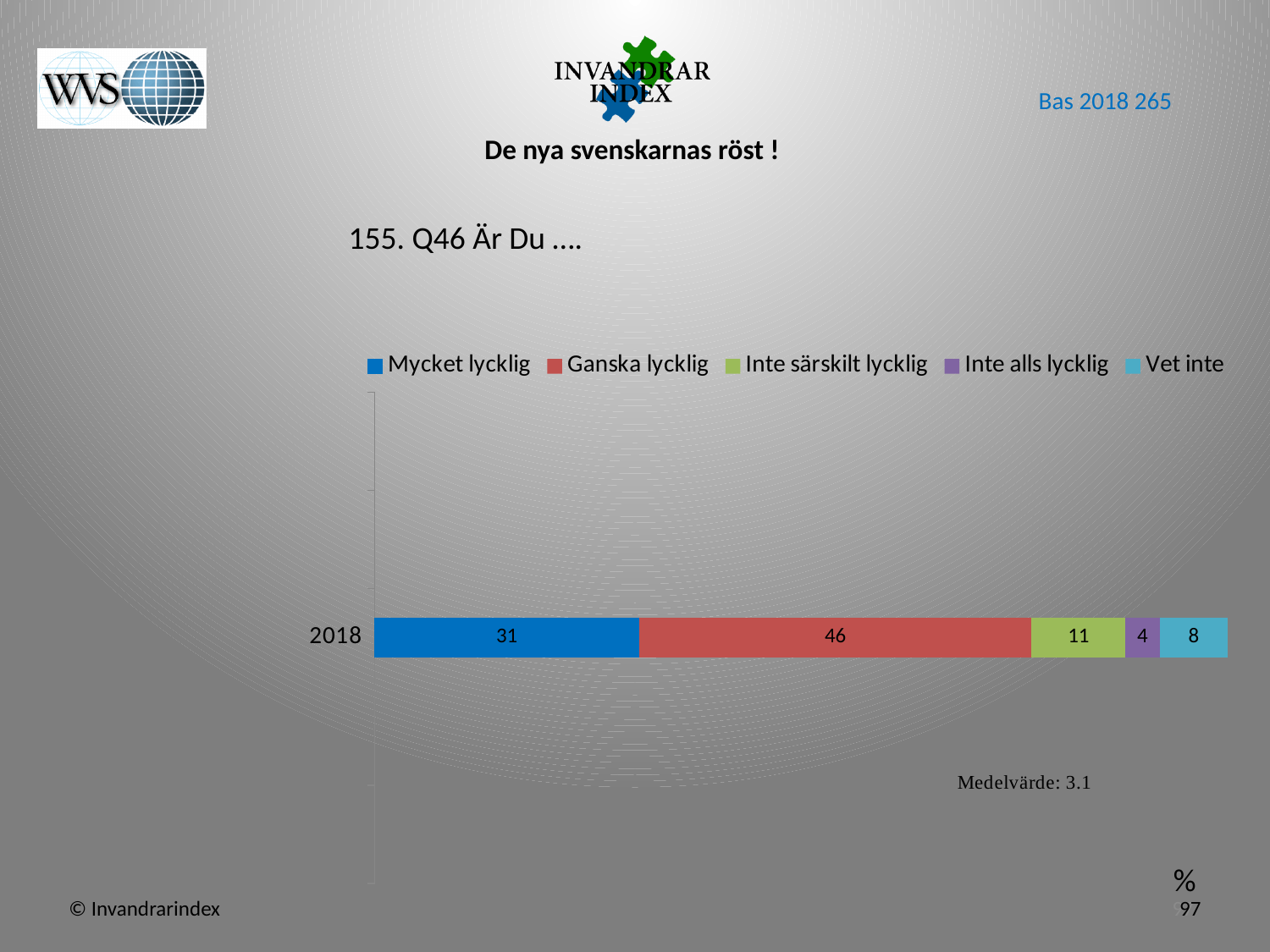
What is the value for "Mycket lycklig" in 2018? 31 Which is larger in 2018, "Inte särskilt lycklig" or "Vet inte"? Inte särskilt lycklig How many series does the legend list? 5 Which series has the lowest value in the 2018 bar? Inte alls lycklig What is the value for "Vet inte" in 2018? 8 What is the value for "Ganska lycklig" in 2018? 46 What is the value for "Inte särskilt lycklig" in 2018? 11 What is the value for "Inte alls lycklig" in 2018? 4 What is the difference between the values for "Ganska lycklig" and "Mycket lycklig" in 2018? 15 What is the total of the stacked bar for 2018? 100 Which series has the highest value in the 2018 bar? Ganska lycklig What kind of chart is shown on the slide? Stacked bar chart